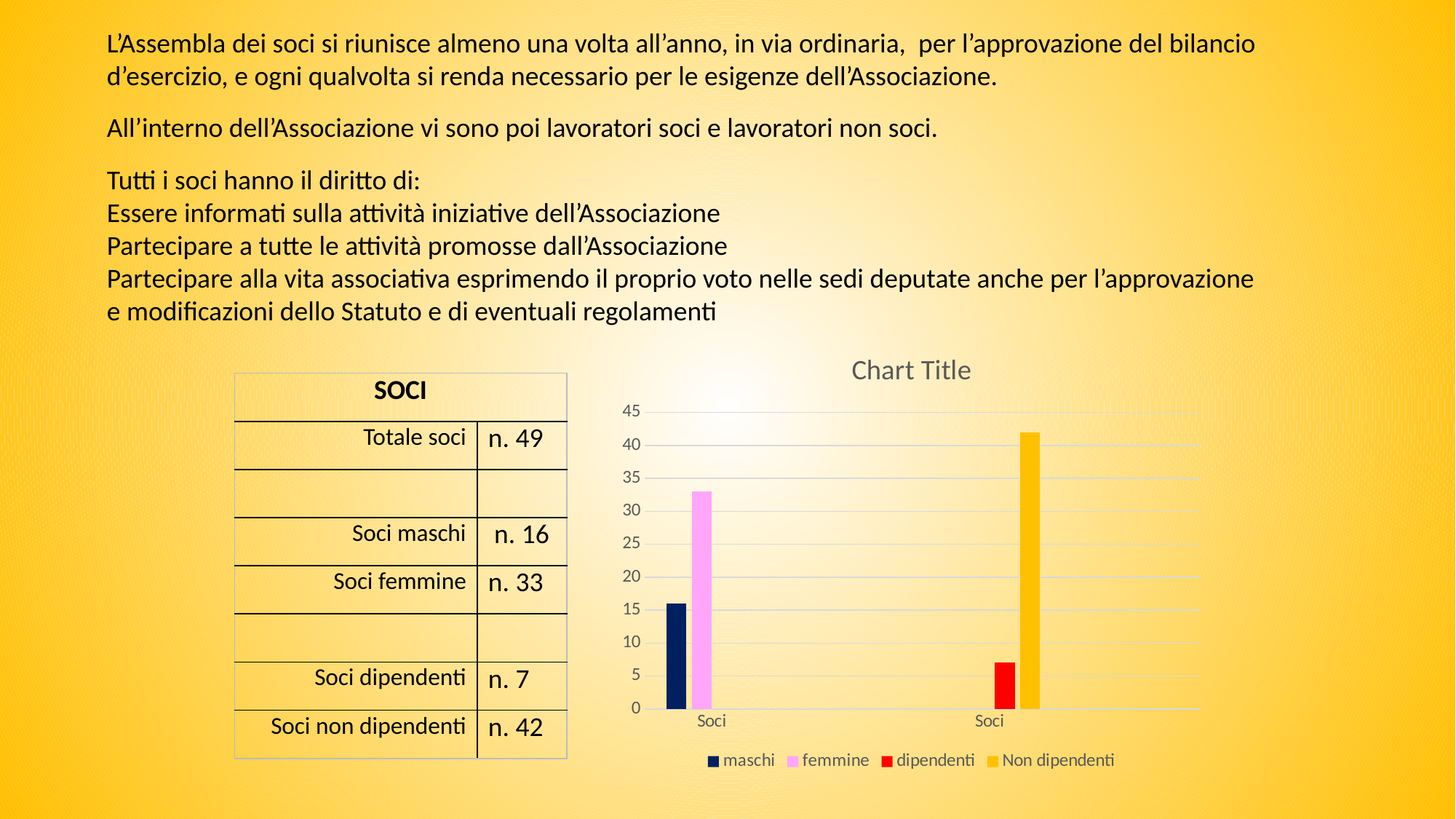
What is the title of the chart? Chart Title How many categories are shown on the x axis of the chart? 2 Is the value for Non dipendenti greater or less than 40? greater Is the value for dipendenti greater or less than 10? less How many series does the chart legend list? 4 Which series has the tallest bar in the chart? Non dipendenti Which is larger in the chart, the bar for femmine or the bar for maschi? femmine What kind of chart is shown on the slide? bar chart Is the value for maschi greater or less than 20? less What is the highest value shown on the chart's vertical axis? 45 Which series has the shortest bar in the chart? dipendenti